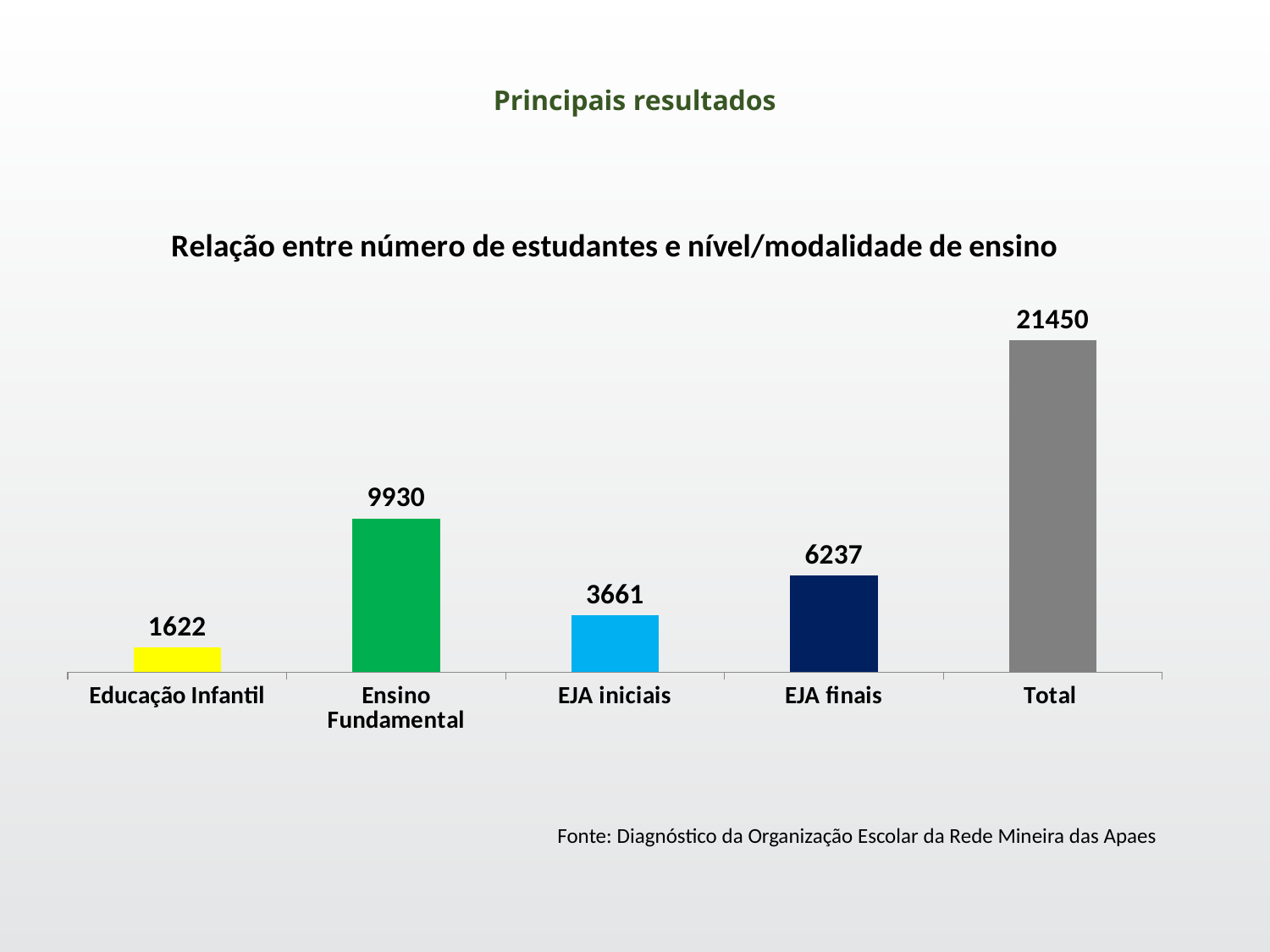
Which is larger, the value for EJA iniciais or the value for EJA finais? EJA finais What is the value shown for Total? 21450 What kind of chart is this? Bar chart How many categories are shown on the x axis? 5 What is the value for Educação Infantil? 1622 What is the value for EJA finais? 6237 Which category has the lowest value? Educação Infantil What is the value for EJA iniciais? 3661 What is the title of the chart? Relação entre número de estudantes e nível/modalidade de ensino Which category has the highest value? Total What is the value for Ensino Fundamental? 9930 What is the difference between the values for Ensino Fundamental and EJA finais? 3693